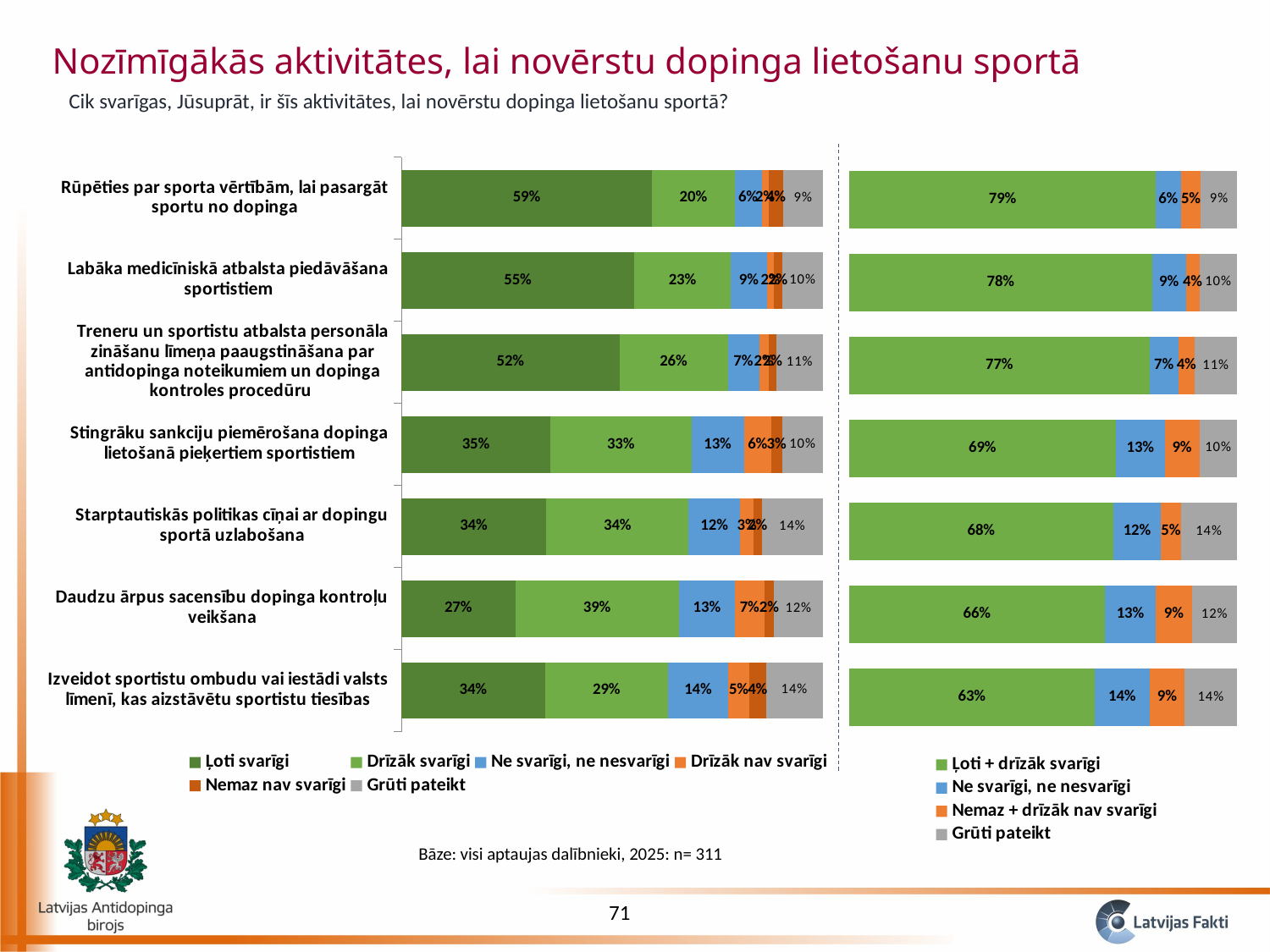
How many series does the legend of the right-hand chart list? 4 In the right-hand chart, which activity has the lowest "Ļoti + drīzāk svarīgi" value? Izveidot sportistu ombudu vai iestādi valsts līmenī, kas aizstāvētu sportistu tiesības How many series does the legend of the left-hand chart list? 6 In the right-hand chart, what is the value of "Ļoti + drīzāk svarīgi" for "Rūpēties par sporta vērtībām, lai pasargāt sportu no dopinga"? 79% In the right-hand chart, what is the "Grūti pateikt" value for "Starptautiskās politikas cīņai ar dopingu sportā uzlabošana"? 14% In the left-hand chart, what is the "Drīzāk svarīgi" value for "Stingrāku sankciju piemērošana dopinga lietošanā pieķertiem sportistiem"? 33% In the left-hand chart, which activity has the highest "Ļoti svarīgi" value? Rūpēties par sporta vērtībām, lai pasargāt sportu no dopinga In the right-hand chart, what is the difference between the "Ļoti + drīzāk svarīgi" values for "Rūpēties par sporta vērtībām, lai pasargāt sportu no dopinga" and "Izveidot sportistu ombudu vai iestādi valsts līmenī, kas aizstāvētu sportistu tiesības"? 16% What type of chart is the right-hand chart? Stacked bar chart How many activities (categories) are shown in the left-hand chart? 7 In the left-hand chart, what is the "Ļoti svarīgi" value for "Daudzu ārpus sacensību dopinga kontroļu veikšana"? 27% In the left-hand chart, which is larger: the "Ļoti svarīgi" value for "Labāka medicīniskā atbalsta piedāvāšana sportistiem" or for "Starptautiskās politikas cīņai ar dopingu sportā uzlabošana"? Labāka medicīniskā atbalsta piedāvāšana sportistiem